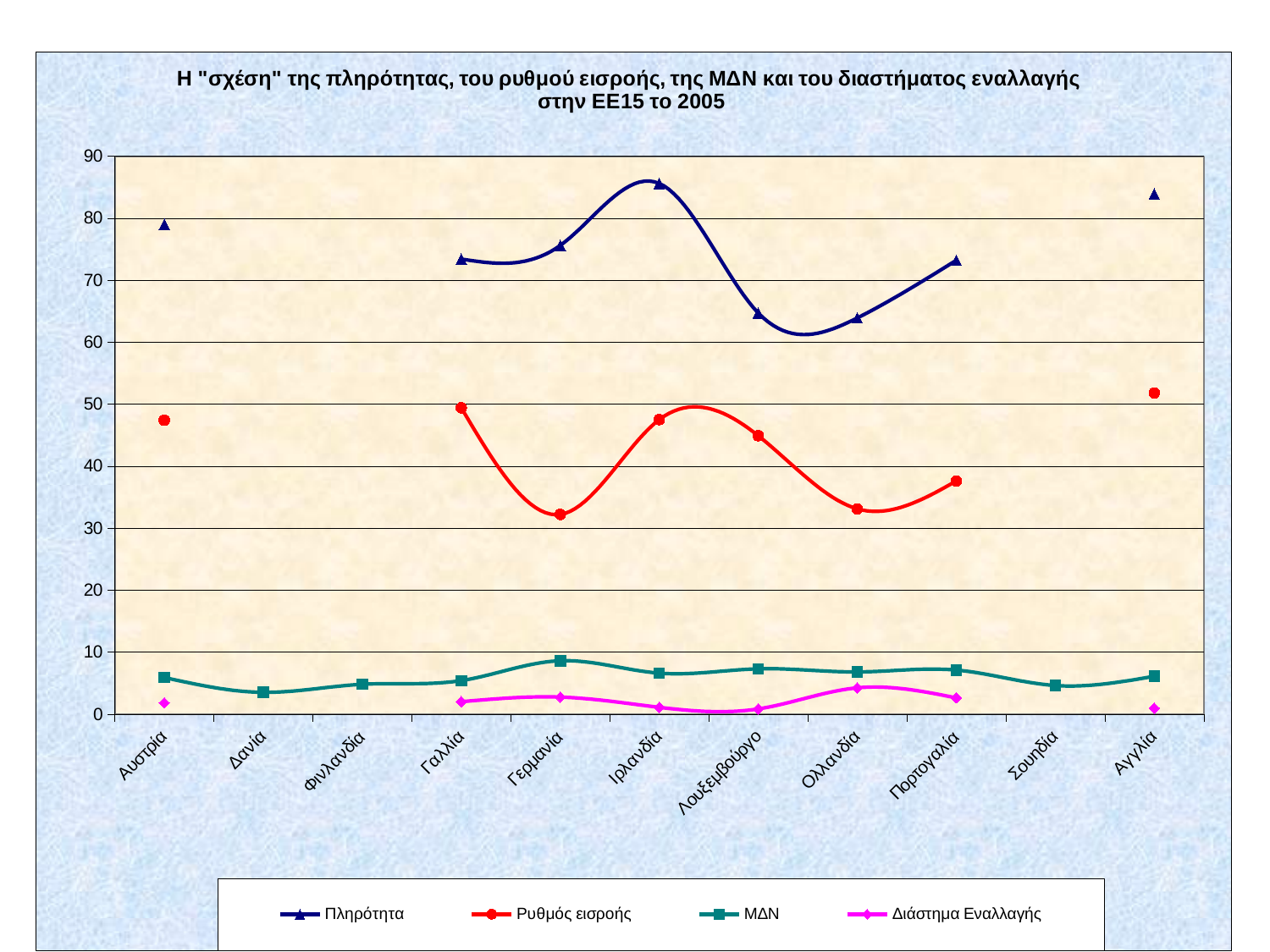
Which is larger, the Ρυθμός εισροής value for Γαλλία or for Γερμανία? Γαλλία How many countries are shown on the x axis? 11 Is the Ρυθμός εισροής value for Αγγλία greater or less than 40? greater Is the Πληρότητα value for Ιρλανδία greater or less than 80? greater Which series is drawn with red circle markers? Ρυθμός εισροής How many series does the legend list? 4 What kind of chart is shown on the slide? line chart Which country has the highest value for Ρυθμός εισροής? Αγγλία Is the Πληρότητα value for Λουξεμβούργο greater or less than 70? less Which country has the highest value for ΜΔΝ? Γερμανία Which is larger, the Πληρότητα value for Ιρλανδία or for Λουξεμβούργο? Ιρλανδία